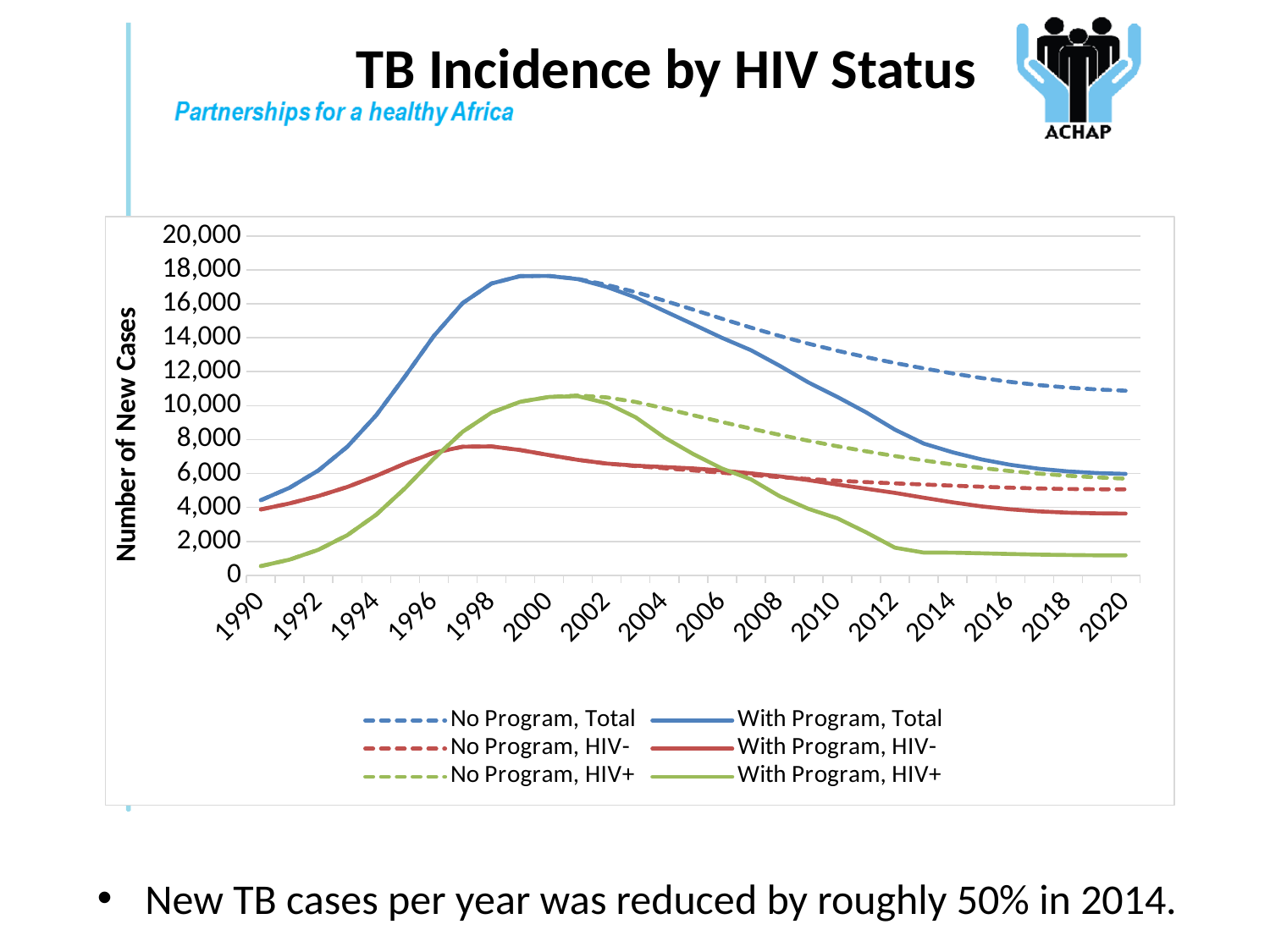
What is the title of the chart? TB Incidence by HIV Status How many series does the legend list? 6 What kind of chart is shown on the slide? line chart In 2020, which is higher: No Program, Total or With Program, Total? No Program, Total What is the label on the vertical axis? Number of New Cases Is the value for With Program, HIV- in 2020 greater or less than 4,000? less Does the With Program, Total line rise or fall from 2000 to 2020? fall Is the peak value of With Program, Total around 2000 greater or less than 16,000? greater Is the value for With Program, HIV+ in 2020 greater or less than 2,000? less How many year labels are shown on the x axis? 16 Which series has the lowest value in 2020? With Program, HIV+